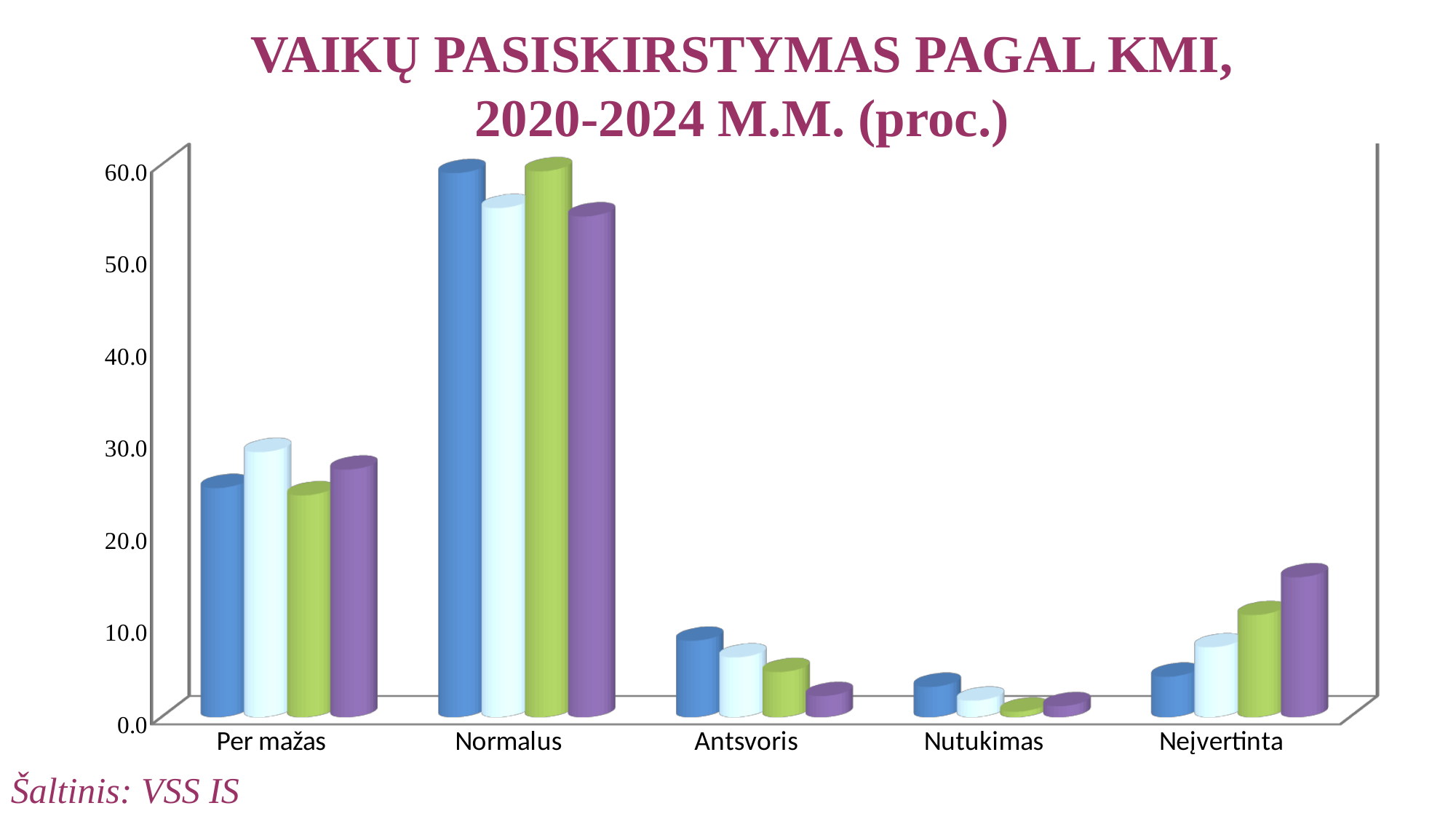
Which category has the lowest bars in the chart? Nutukimas What is the title of the chart? VAIKŲ PASISKIRSTYMAS PAGAL KMI, 2020-2024 M.M. (proc.) Is the value of the purple bar for Neįvertinta greater or less than 10? greater Is the value of the blue bar for Normalus greater or less than 50? greater Which category has the highest bars in the chart? Normalus How many categories are shown on the x axis of the chart? 5 Is the value of the blue bar for Antsvoris greater or less than 10? less Which category has larger values, Per mažas or Neįvertinta? Per mažas What source is cited below the chart? VSS IS What kind of chart is shown on the slide? bar chart Which category has larger values, Normalus or Antsvoris? Normalus